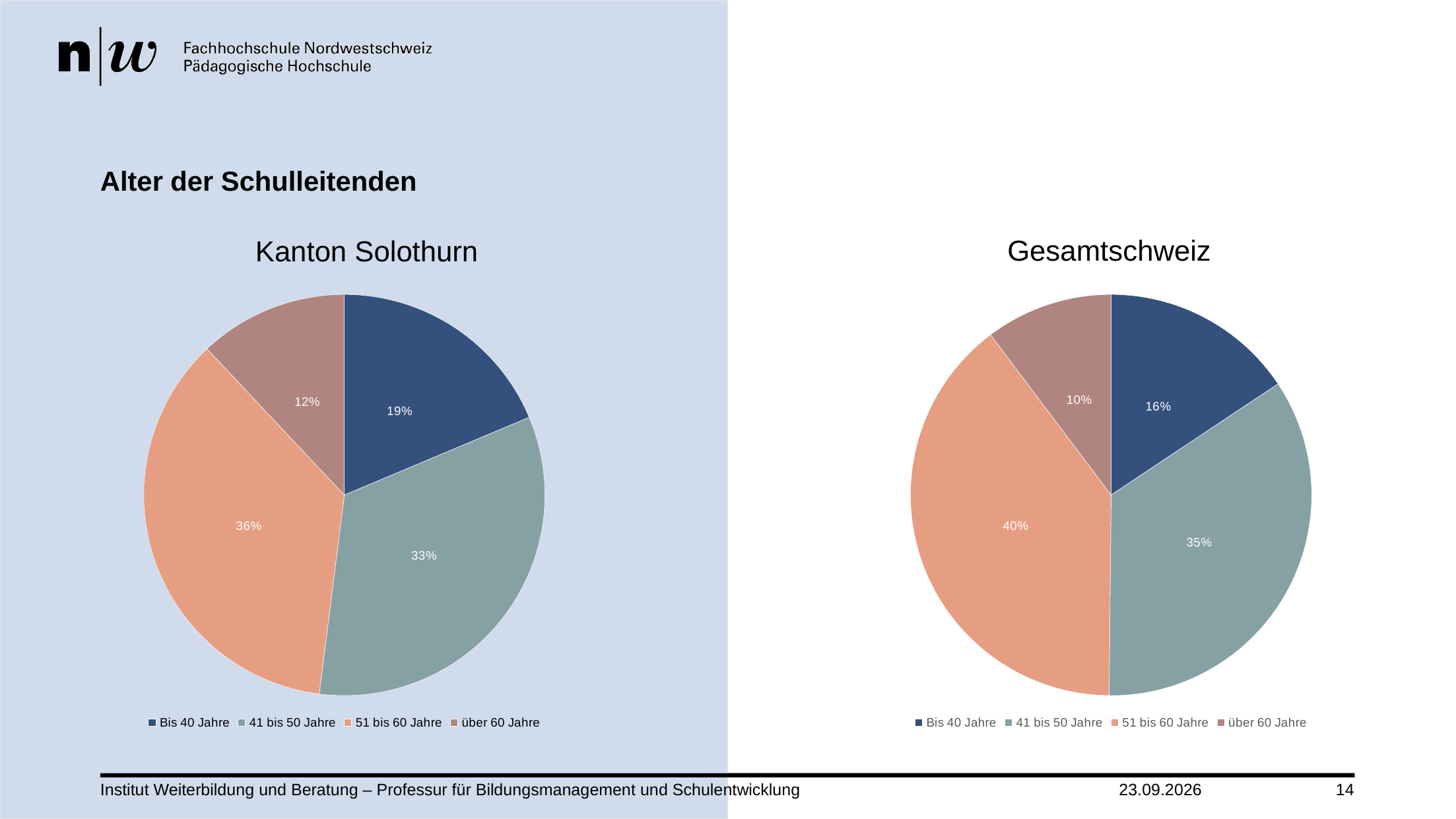
What type of chart is used for Gesamtschweiz? Pie chart In the Gesamtschweiz pie chart, what share do school leaders aged 41 bis 50 Jahre have? 35% In the Gesamtschweiz pie chart, which age group has the smallest share? über 60 Jahre In the Kanton Solothurn pie chart, what is the value for über 60 Jahre? 12% In the Kanton Solothurn pie chart, what share do school leaders aged 51 bis 60 Jahre have? 36% Which is larger: the Bis 40 Jahre share in the Kanton Solothurn chart or the Bis 40 Jahre share in the Gesamtschweiz chart? Kanton Solothurn In the Gesamtschweiz pie chart, which age group has the largest share? 51 bis 60 Jahre How many slices does the Kanton Solothurn pie chart have? 4 In the Kanton Solothurn pie chart, which age group has the largest share? 51 bis 60 Jahre In the Gesamtschweiz pie chart, what is the value for Bis 40 Jahre? 16% What is the title of the chart on the right side of the slide? Gesamtschweiz In the Kanton Solothurn pie chart, what is the difference in percentage points between the 51 bis 60 Jahre and the Bis 40 Jahre slices? 17